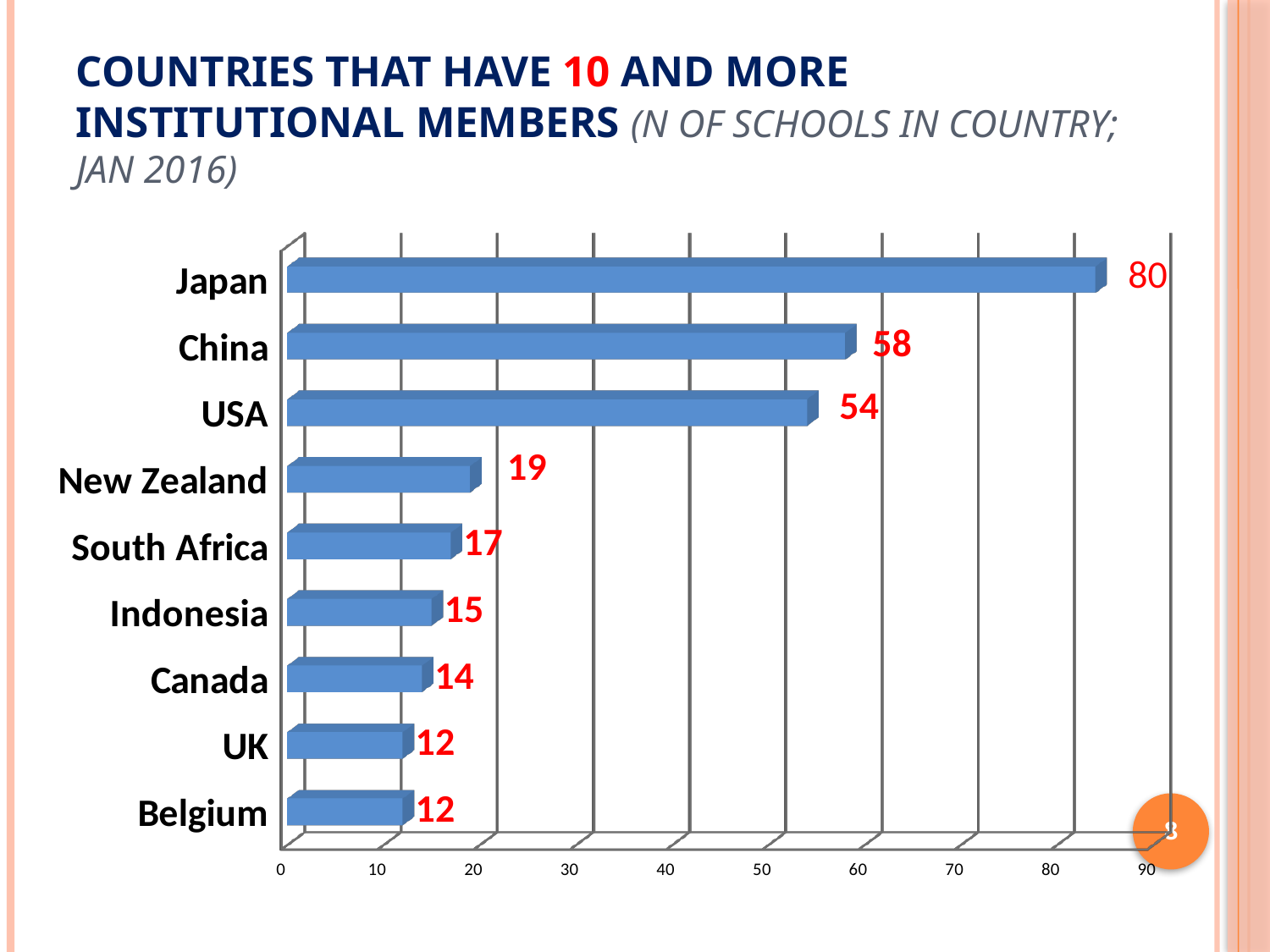
What kind of chart is shown on the slide? bar chart What is the value for Canada? 14 What is the difference between the values for Japan and China? 22 Which country has the highest value? Japan Which two countries share the same value of 12? UK and Belgium What is the value for Japan? 80 What is the difference between the values for China and USA? 4 What is the value for New Zealand? 19 How many countries are shown in the chart? 9 What is the highest tick value shown on the horizontal axis? 90 Which is larger, the value for South Africa or the value for Indonesia? South Africa Is the value for USA greater or less than 50? greater